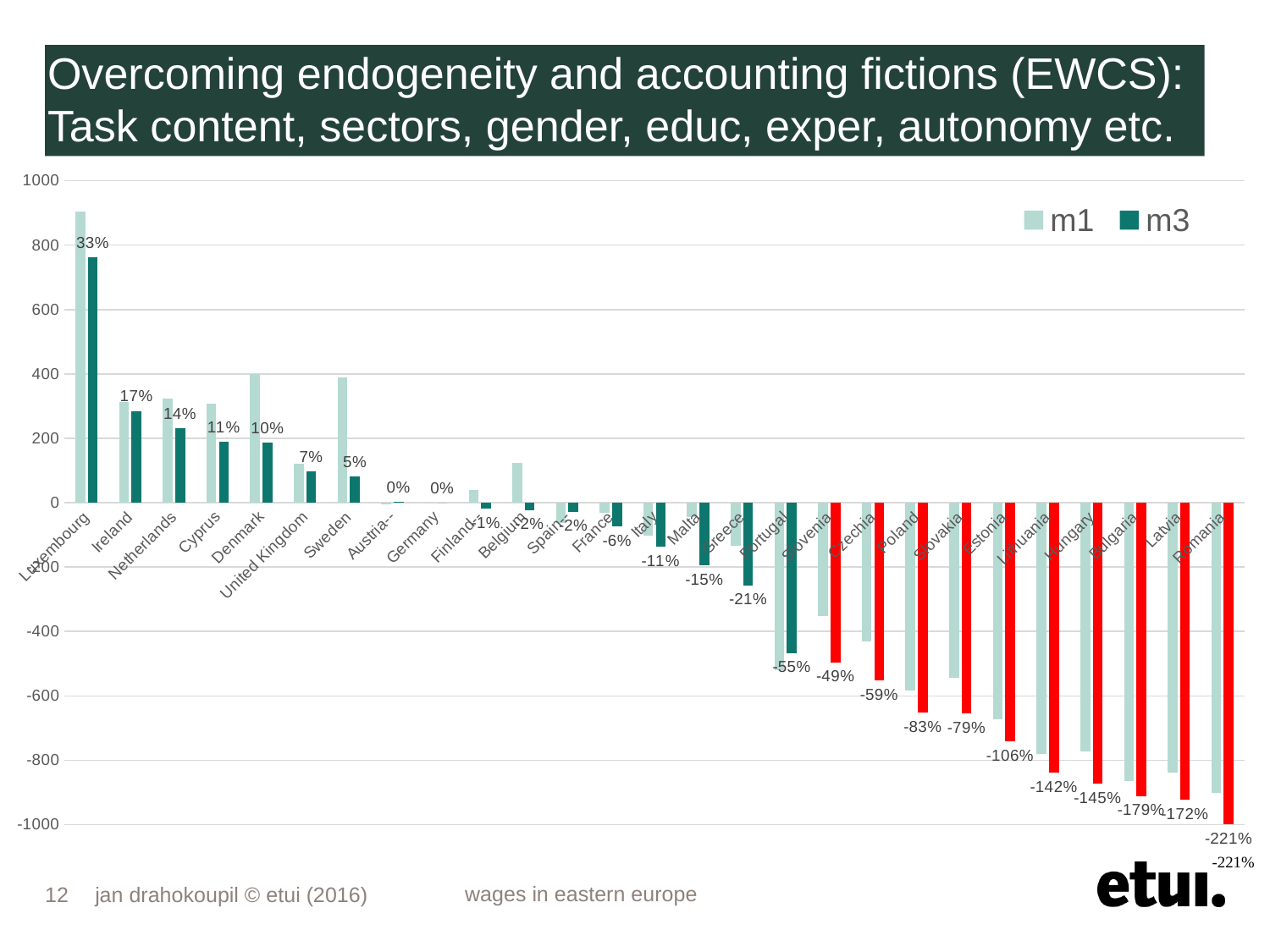
What percentage label is shown for Romania? -221% Which country has the lowest m3 bar? Romania How many series does the legend list? 2 What are the names of the two series in the legend? m1 and m3 Do the values generally rise or fall moving from left to right along the x axis? Fall What percentage label is shown for Estonia? -106% Which country has the highest m1 bar? Luxembourg How many countries are shown on the x axis? 27 What percentage label is shown for Luxembourg? 33% What kind of chart is shown on the slide? Bar chart Is the m1 value for Luxembourg greater or less than 800? greater Which has the larger m3 value, Czechia or Poland? Czechia